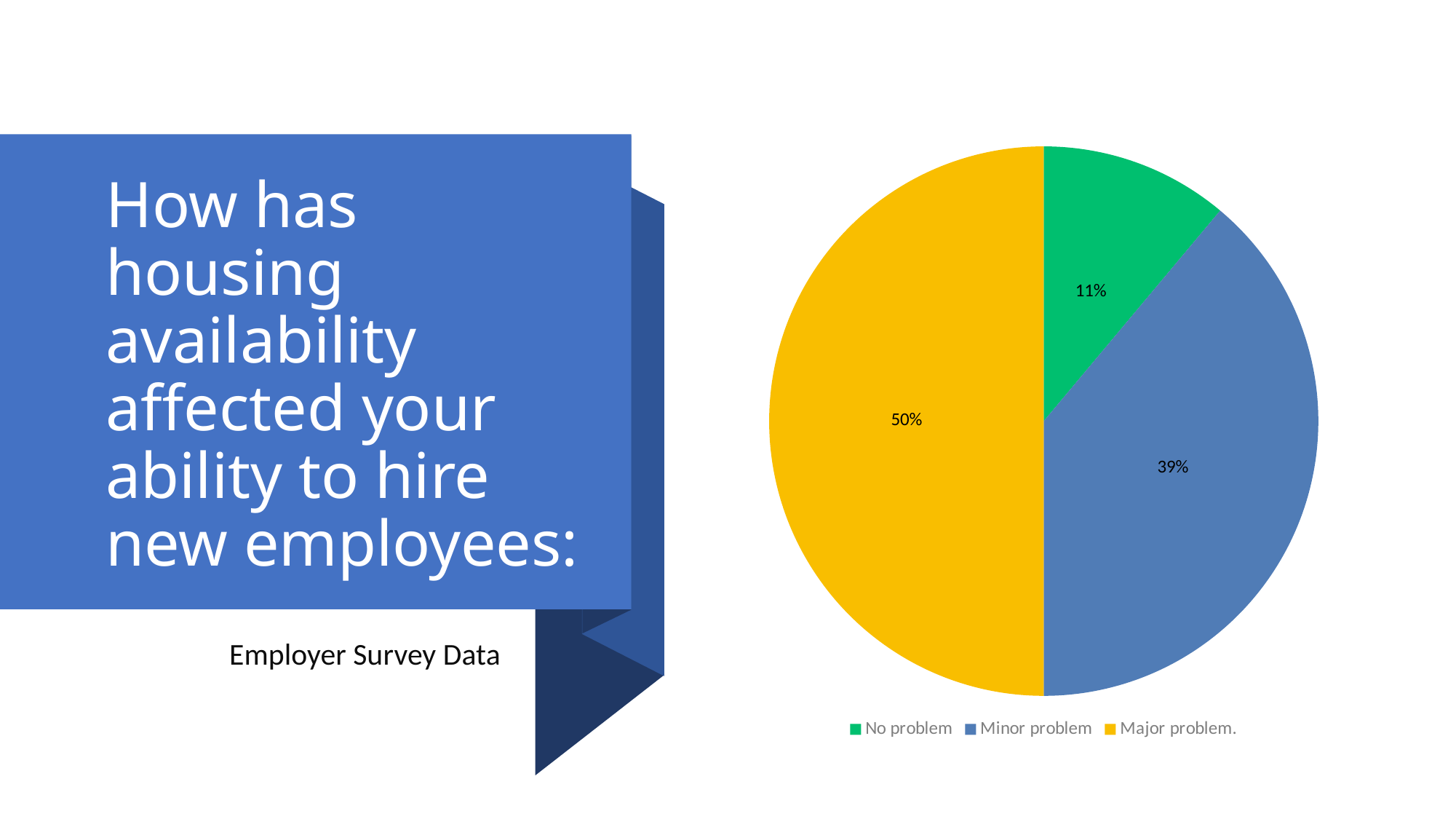
Which category has the smallest slice of the pie? No problem What is the difference in percentage points between the "Major problem." and "Minor problem" slices? 11 What is the difference in percentage points between the "Minor problem" and "No problem" slices? 28 How many slices does the pie chart have? 3 Which slice is larger, "Minor problem" or "No problem"? Minor problem What share of the pie is labelled "Minor problem"? 39% How many entries does the legend list? 3 What share of the pie is labelled "Major problem."? 50% What kind of chart is shown on the slide? pie chart Which category has the largest slice of the pie? Major problem. What share of the pie is labelled "No problem"? 11% What colour is the "Major problem." slice? yellow